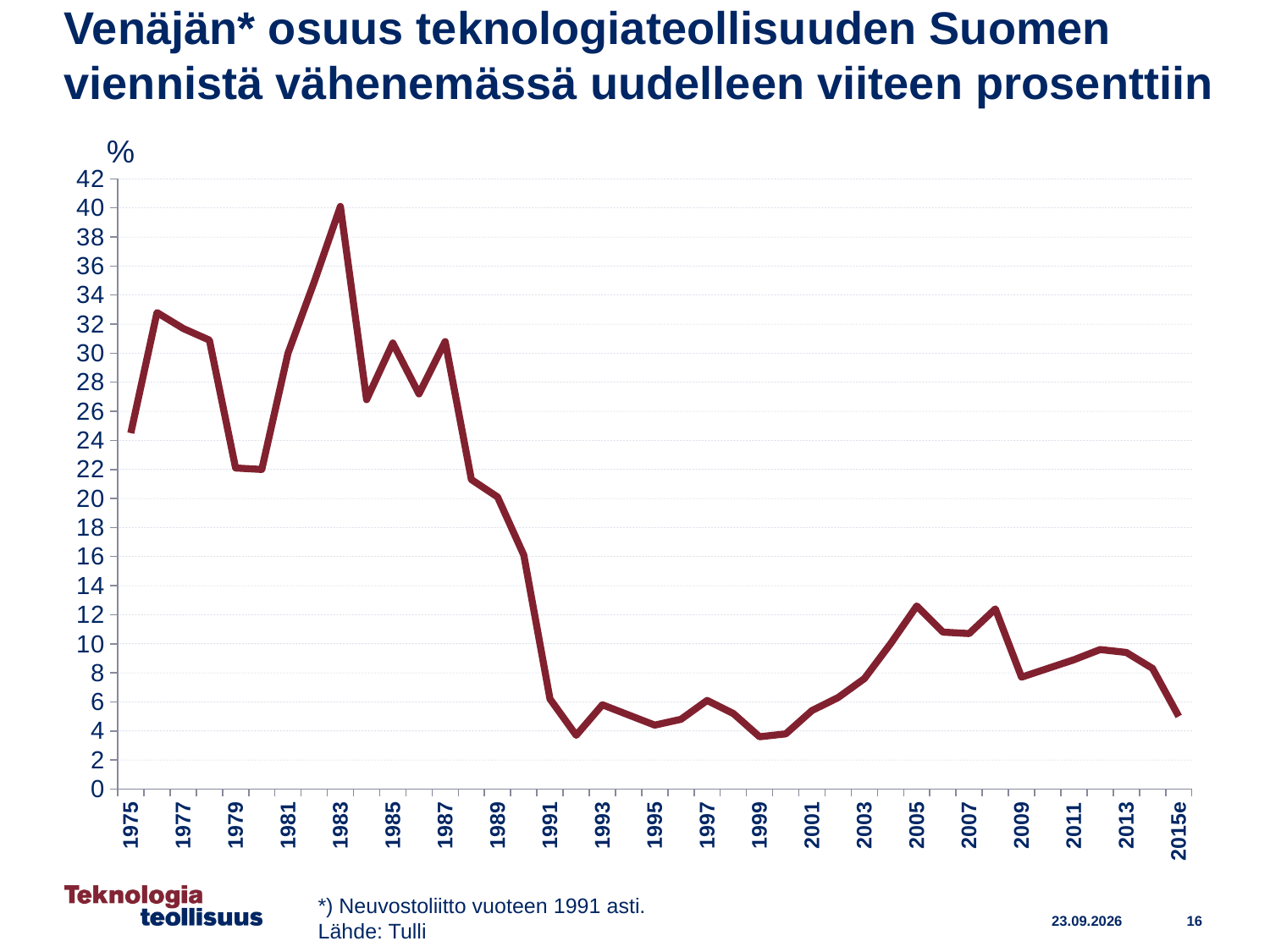
Is the value for 1983 greater or less than 38? greater Is the value for 1985 greater or less than 28? greater Is the value for 2009 greater or less than 10? less What kind of chart is shown on the slide? line chart What unit is shown at the top of the y axis? % In which year does the line reach its highest value? 1983 Which year has the larger value, 1983 or 1987? 1983